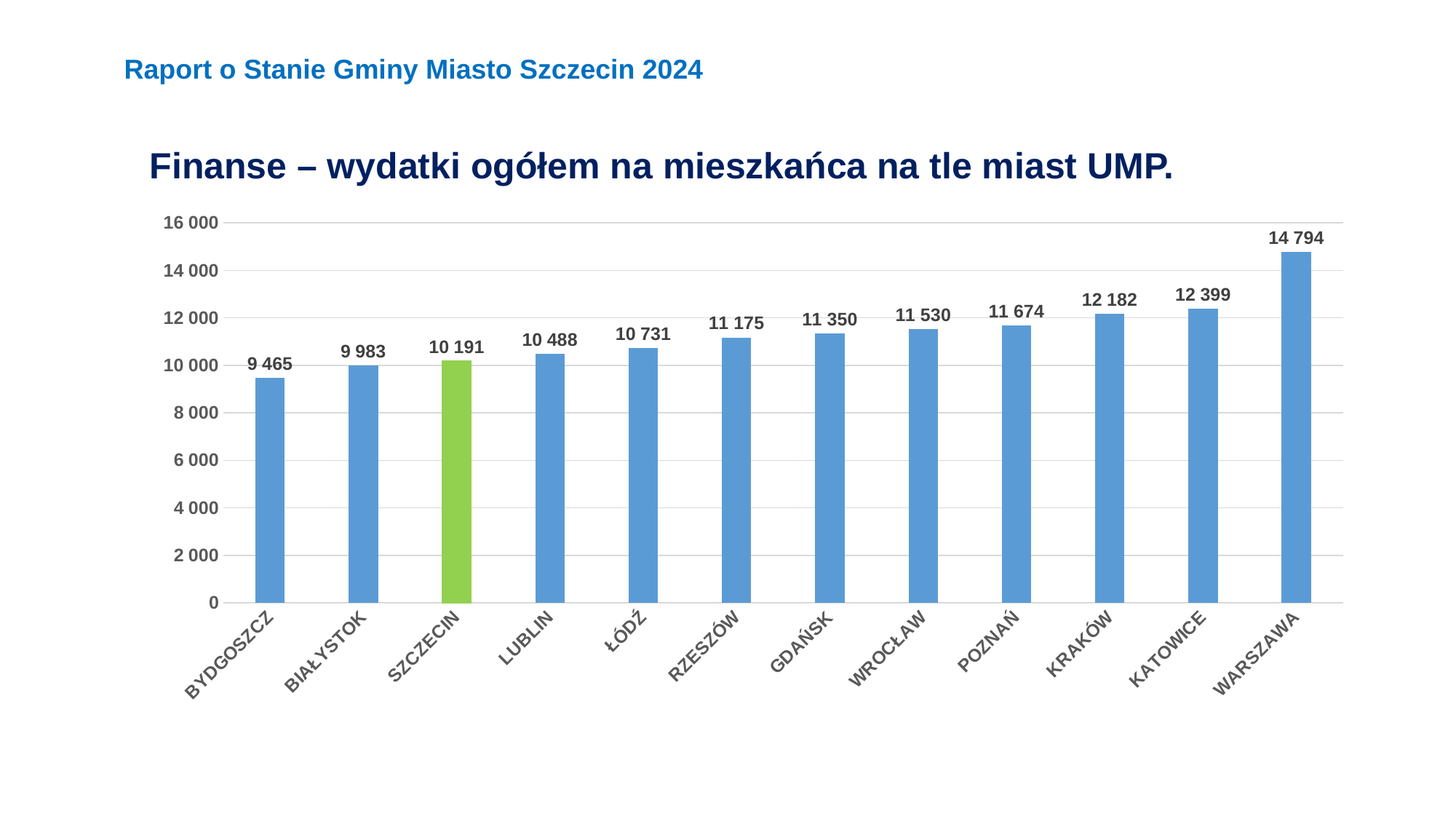
How many cities are shown on the chart? 12 What is the value for GDAŃSK? 11 350 Which city has the lowest value? BYDGOSZCZ What is the value for SZCZECIN? 10 191 Is the value for BIAŁYSTOK greater or less than 10 000? less What is the difference between the values for WARSZAWA and SZCZECIN? 4 603 Which is larger, the value for LUBLIN or the value for POZNAŃ? POZNAŃ Which bar is coloured green instead of blue? SZCZECIN What kind of chart is shown on the slide? bar chart Which city has the highest value? WARSZAWA What is the difference between the values for KATOWICE and KRAKÓW? 217 What is the value for WARSZAWA? 14 794